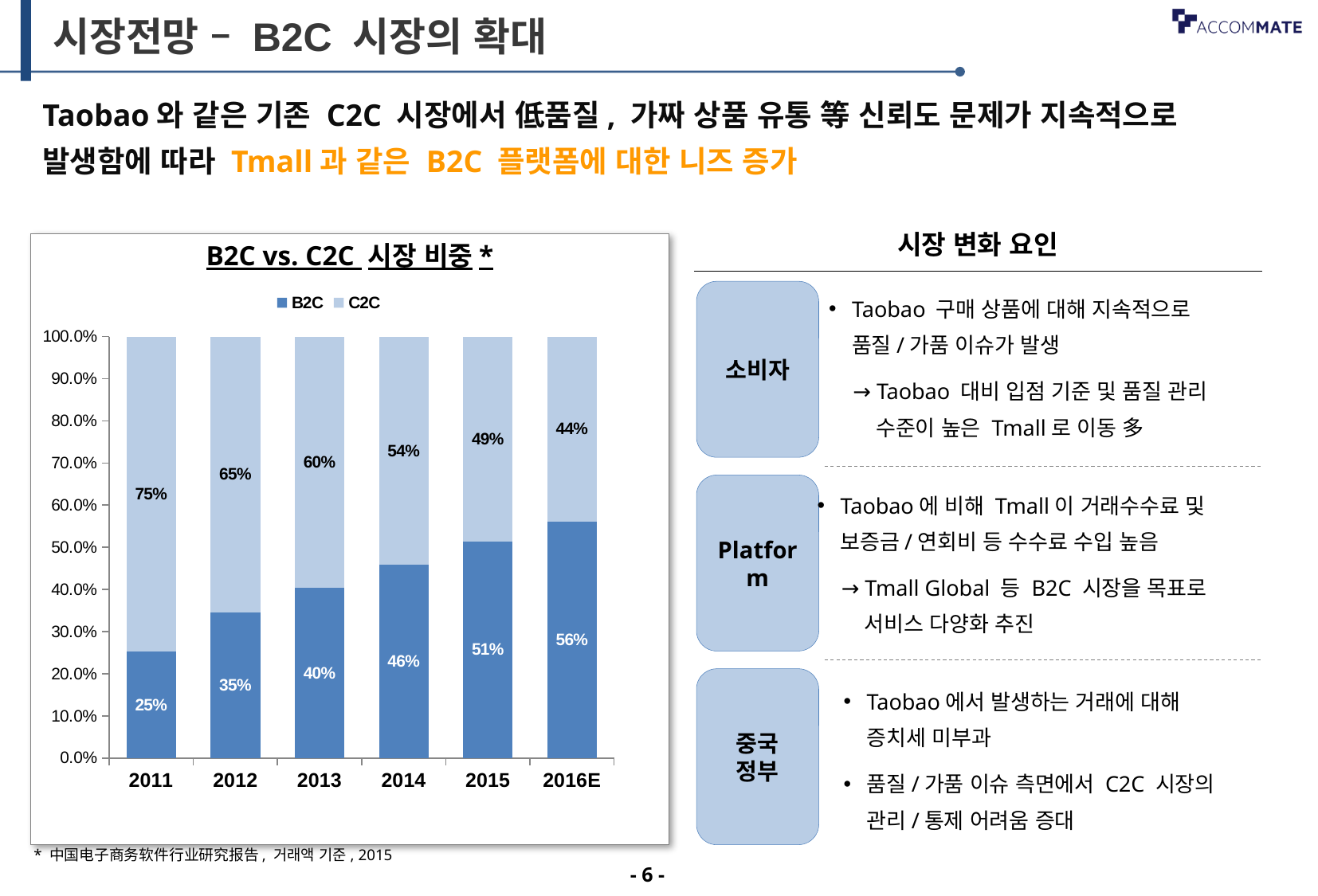
What is the C2C value for 2015 in the B2C vs. C2C 시장 비중 chart? 49% What kind of chart is the B2C vs. C2C 시장 비중 chart? Stacked bar chart How many series does the legend of the B2C vs. C2C 시장 비중 chart list? 2 How many years are shown on the x axis of the B2C vs. C2C 시장 비중 chart? 6 In which year is the C2C share lowest in the B2C vs. C2C 시장 비중 chart? 2016E What is the total of the stacked bar for 2012 in the B2C vs. C2C 시장 비중 chart? 100% Does the B2C share rise or fall from 2011 to 2016E in the B2C vs. C2C 시장 비중 chart? Rise What is the B2C value for 2016E in the B2C vs. C2C 시장 비중 chart? 56% What is the B2C value for 2013 in the B2C vs. C2C 시장 비중 chart? 40% Which is larger in 2014 in the B2C vs. C2C 시장 비중 chart, the B2C value or the C2C value? C2C In which year is the B2C share highest in the B2C vs. C2C 시장 비중 chart? 2016E What is the difference between the C2C and B2C values for 2011 in the B2C vs. C2C 시장 비중 chart? 50%